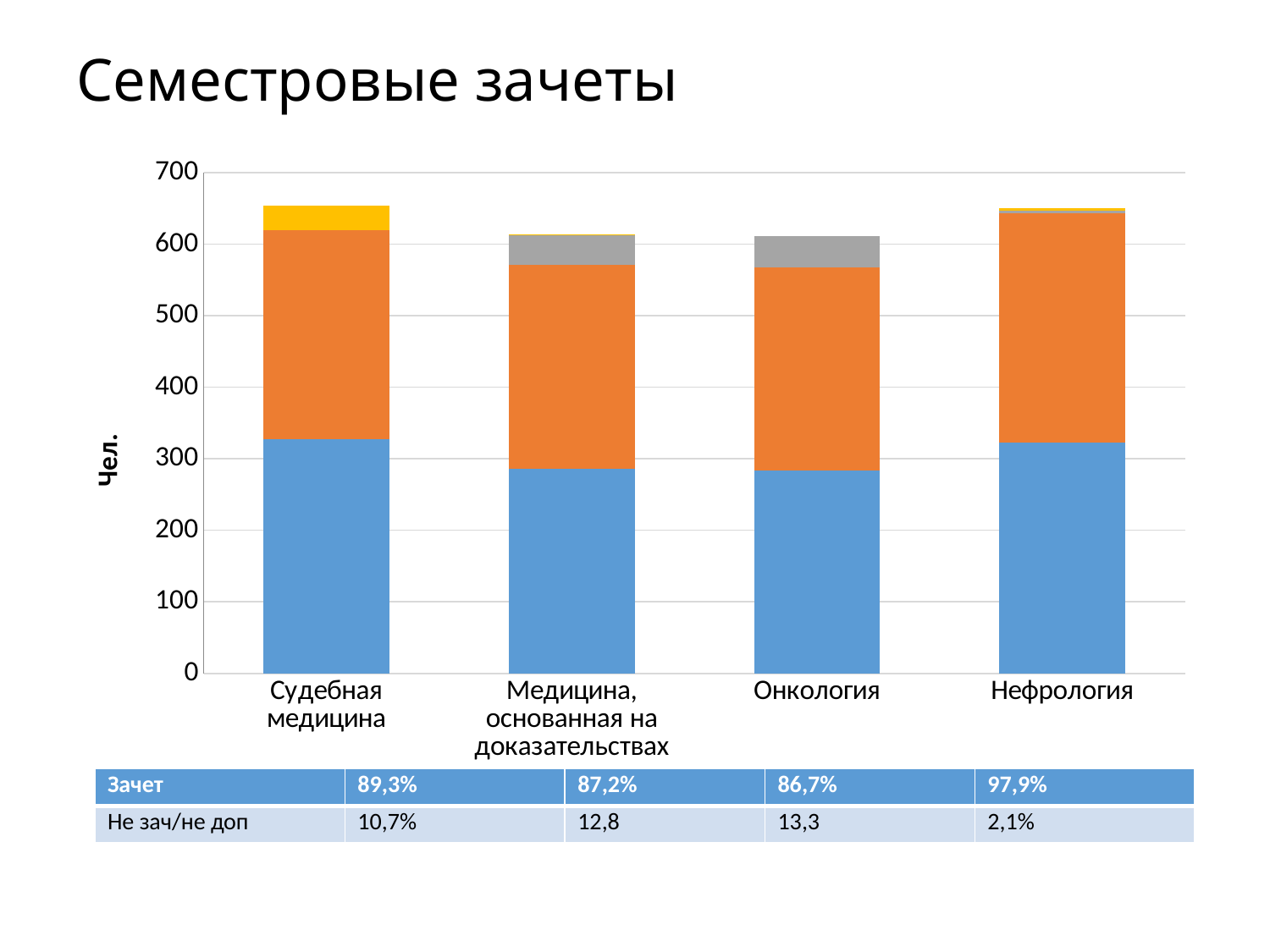
According to the table under the chart, what is the Зачет percentage for Нефрология? 97,9% How many categories are shown on the x axis of the chart? 4 Is the blue segment of the bar for Судебная медицина greater or less than 300? greater According to the table under the chart, what is the Не зач/не доп value for Судебная медицина? 10,7% Which blue segment is larger: Нефрология or Медицина, основанная на доказательствах? Нефрология Is the total height of the bar for Судебная медицина greater or less than 600? greater Is the total height of the bar for Нефрология greater or less than 600? greater What is the label of the vertical axis of the chart? Чел. What kind of chart is shown on the slide? Stacked bar chart Which bar is taller in total: Судебная медицина or Онкология? Судебная медицина What is the title of the slide above the chart? Семестровые зачеты